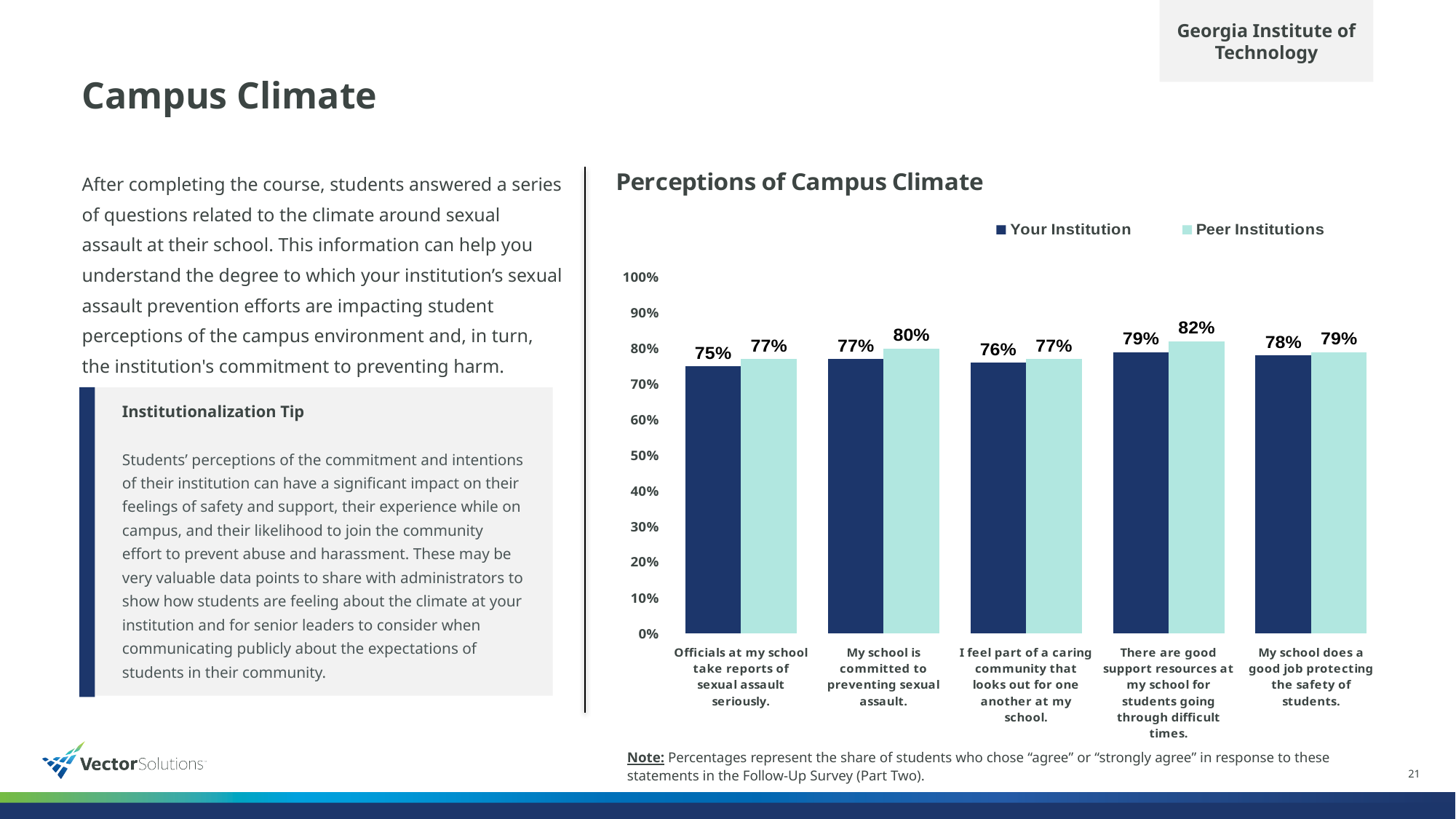
What is the Your Institution value for "There are good support resources at my school for students going through difficult times."? 79% What is the Your Institution value for "Officials at my school take reports of sexual assault seriously."? 75% What is the Peer Institutions value for "My school is committed to preventing sexual assault."? 80% How many categories are shown on the x axis of the chart? 5 What kind of chart is shown on the slide? Bar chart What is the title of the chart? Perceptions of Campus Climate For "My school does a good job protecting the safety of students.", which series has the larger value, Your Institution or Peer Institutions? Peer Institutions How many series does the legend list? 2 Which category has the lowest Your Institution value? Officials at my school take reports of sexual assault seriously. Which series is shown in dark blue in the legend? Your Institution What is the difference between the Peer Institutions and Your Institution values for "My school is committed to preventing sexual assault."? 3% Which category has the highest Peer Institutions value? There are good support resources at my school for students going through difficult times.